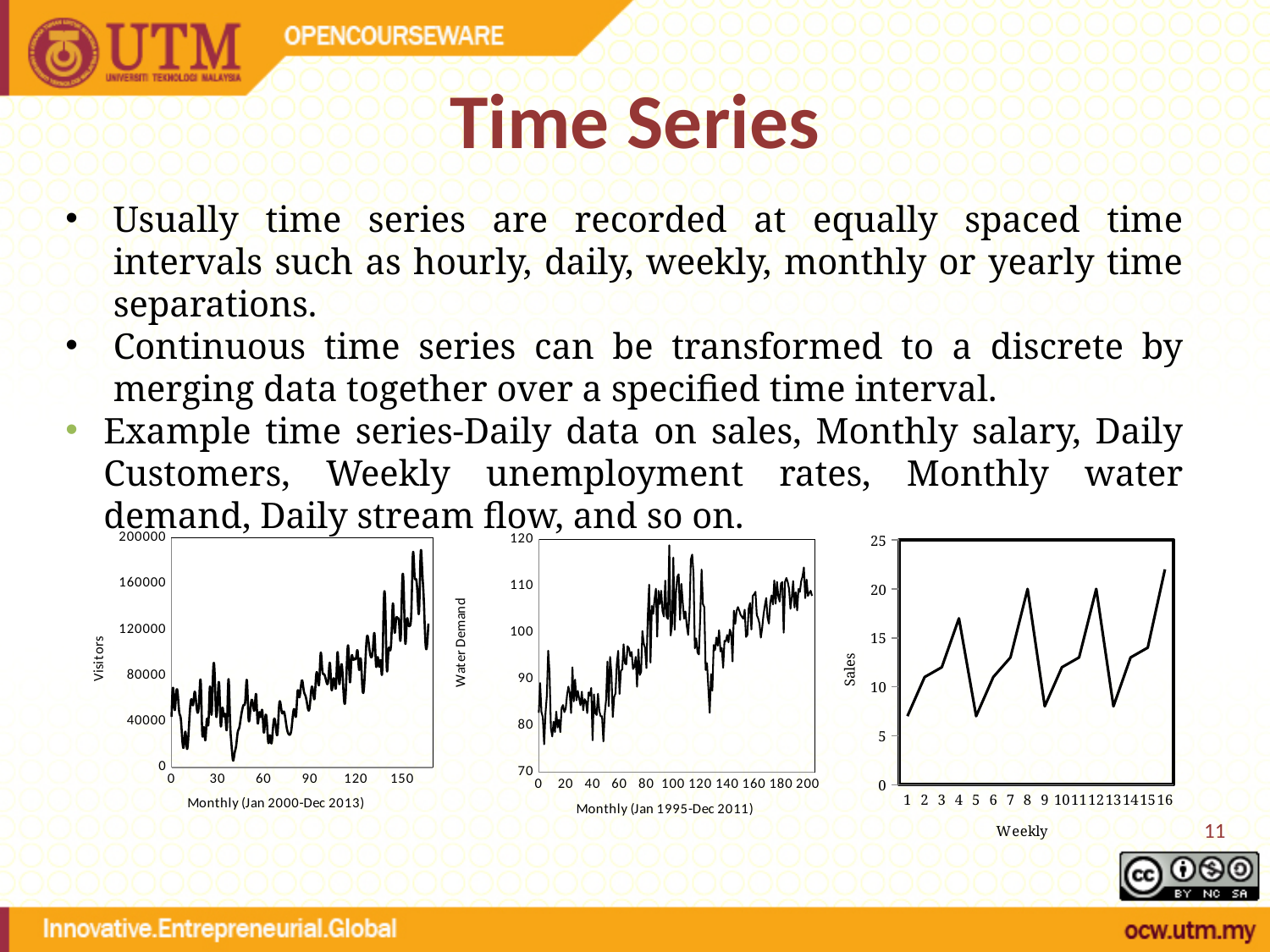
What is the x-axis label of the middle chart (Water Demand)? Monthly (Jan 1995-Dec 2011) How many charts are shown on the slide? 3 In the right-hand chart (Sales), is the value for week 16 greater or less than 20? greater In the right-hand chart (Sales), at which week is the value highest? 16 In the right-hand chart (Sales), is the value for week 5 greater or less than 10? less What is the y-axis label of the left-hand chart? Visitors In the right-hand chart (Sales), how many weekly points are labelled on the x axis? 16 What kind of chart is the chart on the left of the slide (Visitors)? line chart In the right-hand chart (Sales), is the value for week 8 greater or less than 15? greater In the right-hand chart (Sales), which is larger, the value for week 8 or the value for week 9? week 8 In the middle chart (Water Demand), do the values generally rise or fall from left to right along the x axis? rise In the left-hand chart (Visitors), do the values generally rise or fall from left to right along the x axis? rise